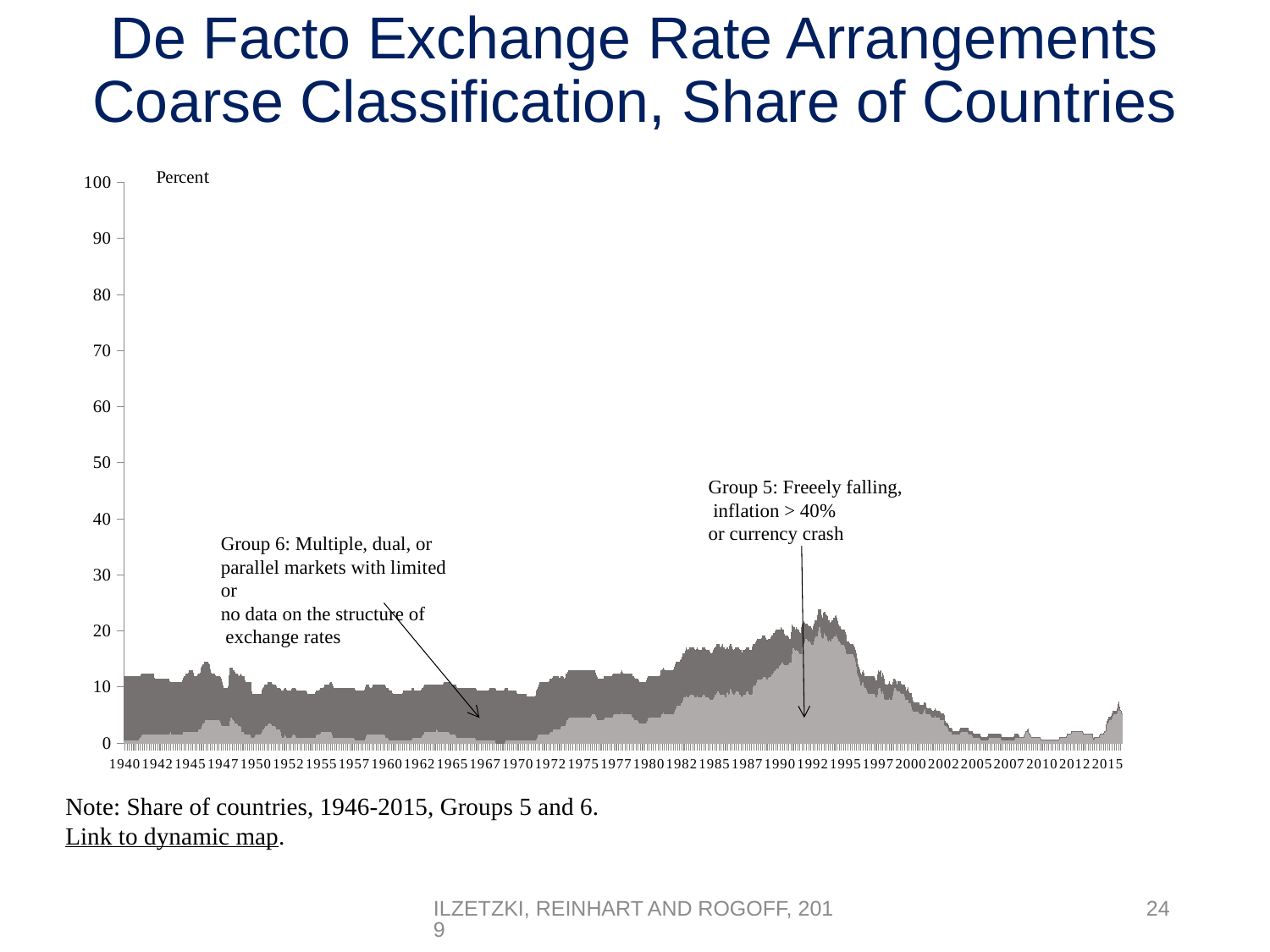
How many groups (series) are plotted in the chart? 2 What kind of chart is shown on the slide? Stacked area chart Which group is described as 'Freely falling, inflation > 40% or currency crash'? Group 5 Is the combined share of countries in Groups 5 and 6 around 1993 greater or less than 30? less Is the combined share of countries in Groups 5 and 6 around 1985 greater or less than 10? greater Is the combined share of countries in Groups 5 and 6 around 2007 greater or less than 10? less In which decade does the combined share of countries in Groups 5 and 6 reach its peak? 1990s What is the label on the vertical axis of the chart? Percent Does the combined share of countries in Groups 5 and 6 rise or fall between 1980 and 1993? rise Does the combined share of countries in Groups 5 and 6 rise or fall between 1995 and 2007? fall What is the maximum value shown on the vertical axis? 100